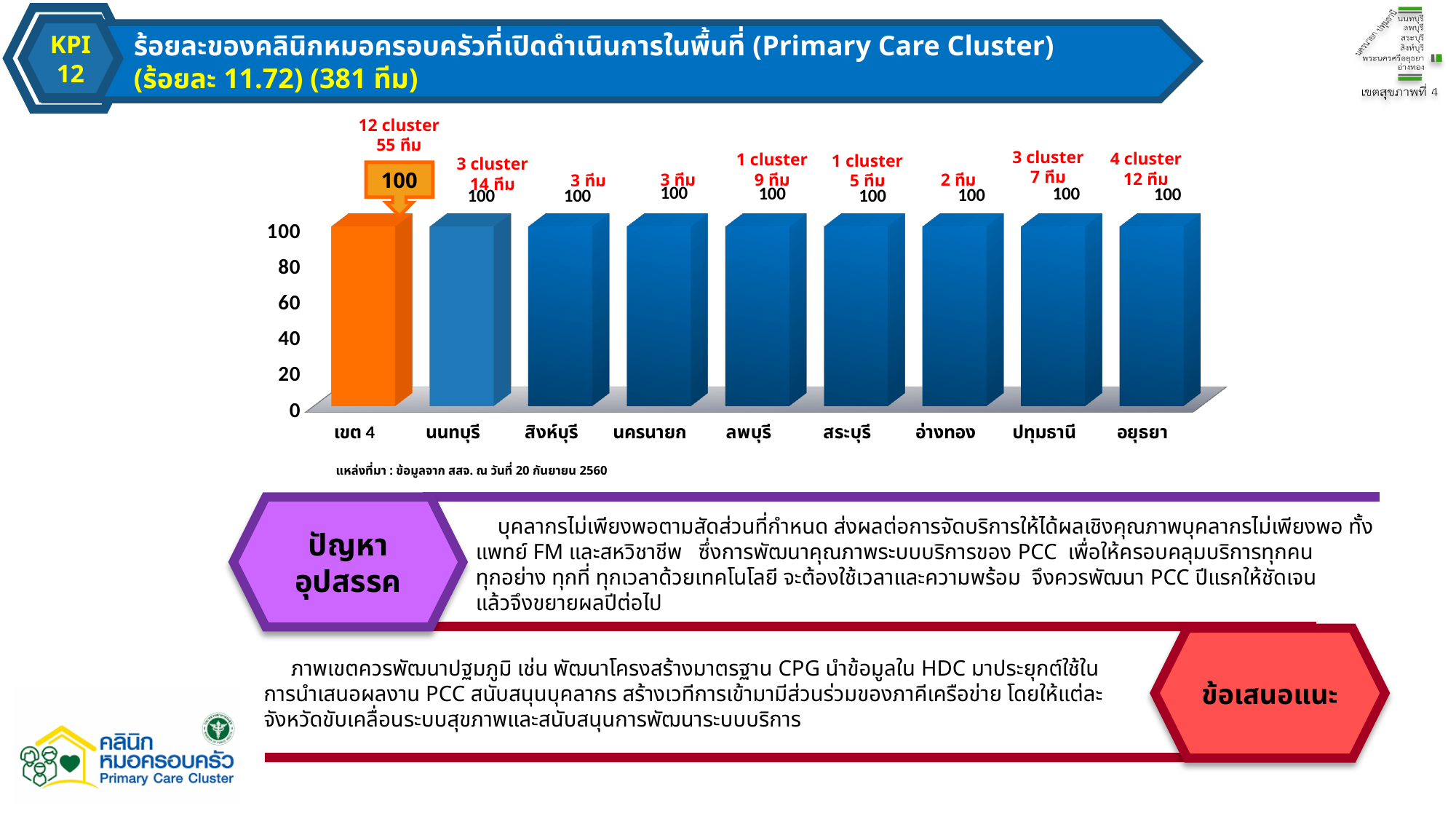
How many teams (ทีม) are annotated above the ปทุมธานี bar? 7 ทีม How many teams (ทีม) are annotated above the นนทบุรี bar? 14 ทีม Which category is the first (leftmost) on the x axis? เขต 4 How many clusters are annotated above the เขต 4 bar? 12 cluster What is the value shown for เขต 4? 100 What is the value shown for นนทบุรี? 100 How many categories are shown on the x axis of the chart? 9 Is the value for สระบุรี greater or less than 80? greater What colour is the bar for เขต 4? orange What is the value shown for อยุธยา? 100 What is the difference between the values for สิงห์บุรี and ลพบุรี? 0 What type of chart is shown on the slide? bar chart